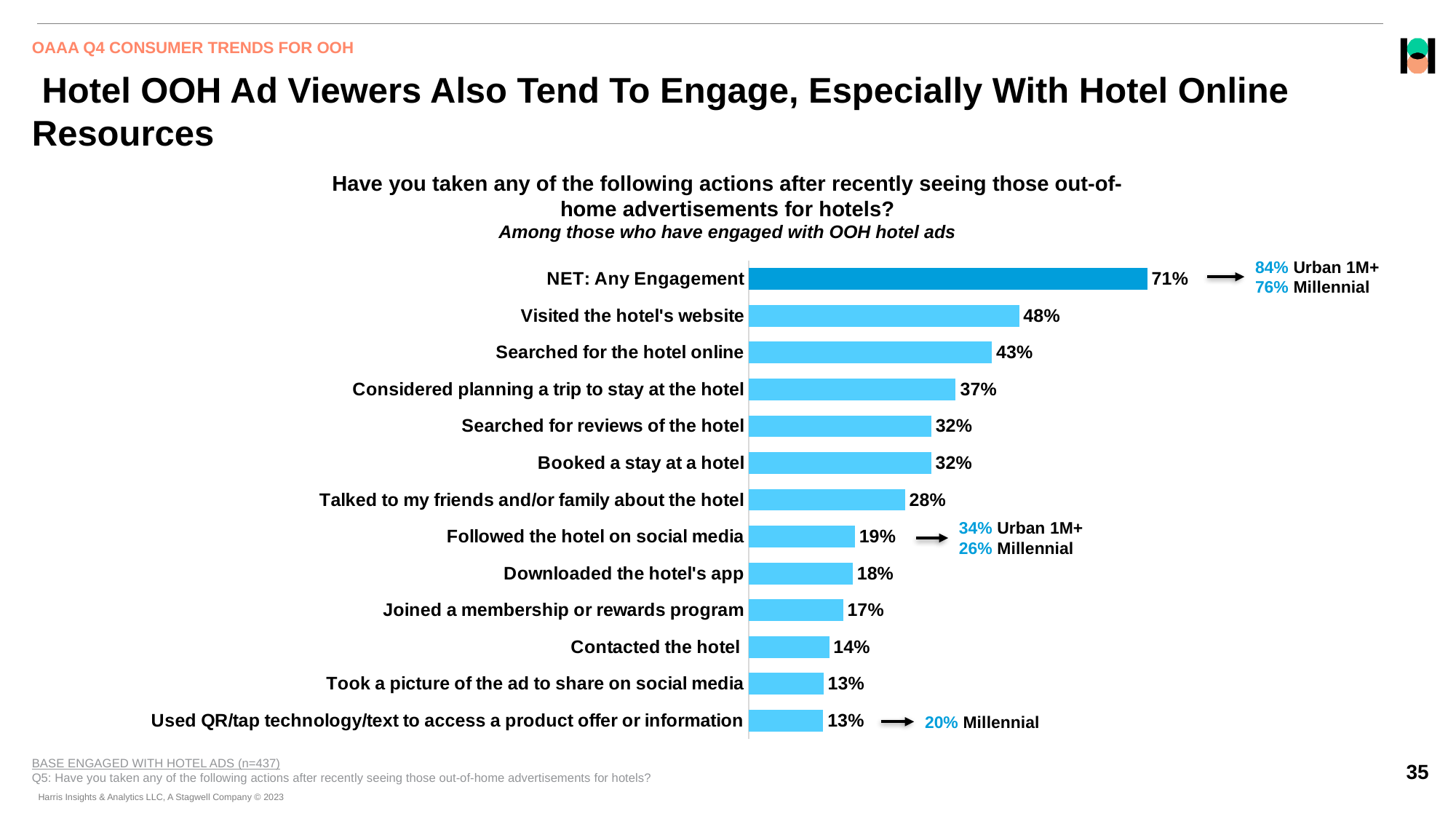
Which action has the lowest percentage, tied with 'Used QR/tap technology/text to access a product offer or information'? Took a picture of the ad to share on social media What is the value for 'Followed the hotel on social media'? 19% How many bars are shown in the chart, including the NET bar? 13 Which is larger: 'Talked to my friends and/or family about the hotel' or 'Downloaded the hotel's app'? Talked to my friends and/or family about the hotel What is the difference between 'Visited the hotel's website' and 'Searched for the hotel online'? 5% What percentage of respondents visited the hotel's website? 48% What is the Urban 1M+ value annotated next to the 'NET: Any Engagement' bar? 84% What is the difference between 'Considered planning a trip to stay at the hotel' and 'Contacted the hotel'? 23% What is the value for 'NET: Any Engagement'? 71% What type of chart is shown on the slide? Bar chart What is the value for 'Booked a stay at a hotel'? 32% Excluding the NET bar, which action has the highest percentage? Visited the hotel's website